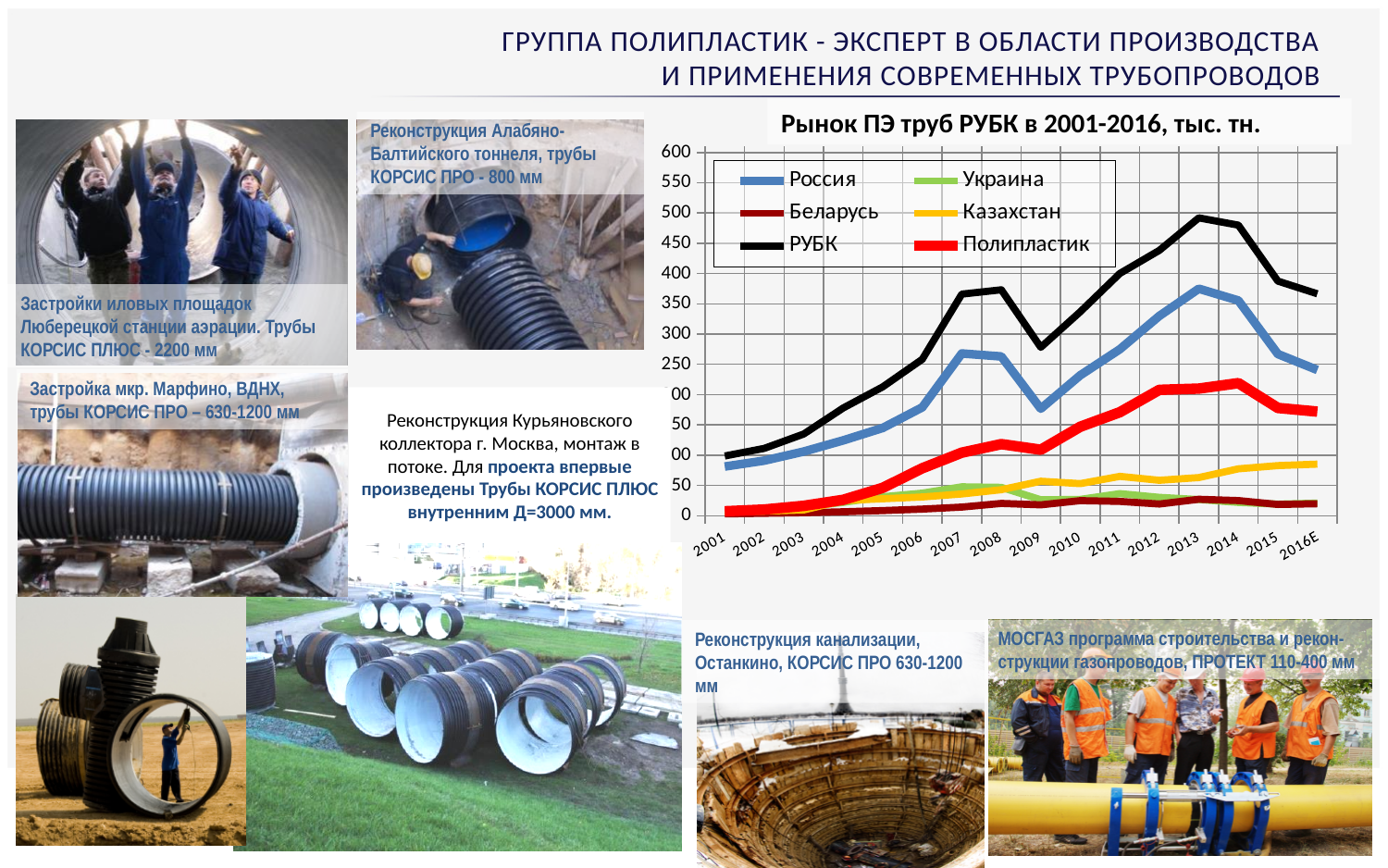
Which series has the highest value in 2013? РУБК How many series does the chart legend list? 6 Is the value for РУБК in 2001 greater or less than 150? less In 2016E, which is larger: the value for Россия or the value for Полипластик? Россия Is the value for Полипластик in 2014 greater or less than 150? greater How many years are shown along the x axis of the chart? 16 Which series has the lowest value in 2007? Беларусь What is the title of the chart? Рынок ПЭ труб РУБК в 2001-2016, тыс. тн. Does the РУБК line rise or fall from 2013 to 2016E? fall Is the value for РУБК in 2013 greater or less than 450? greater What kind of chart is shown on the slide? line chart In 2016E, which is larger: the value for Казахстан or the value for Украина? Казахстан